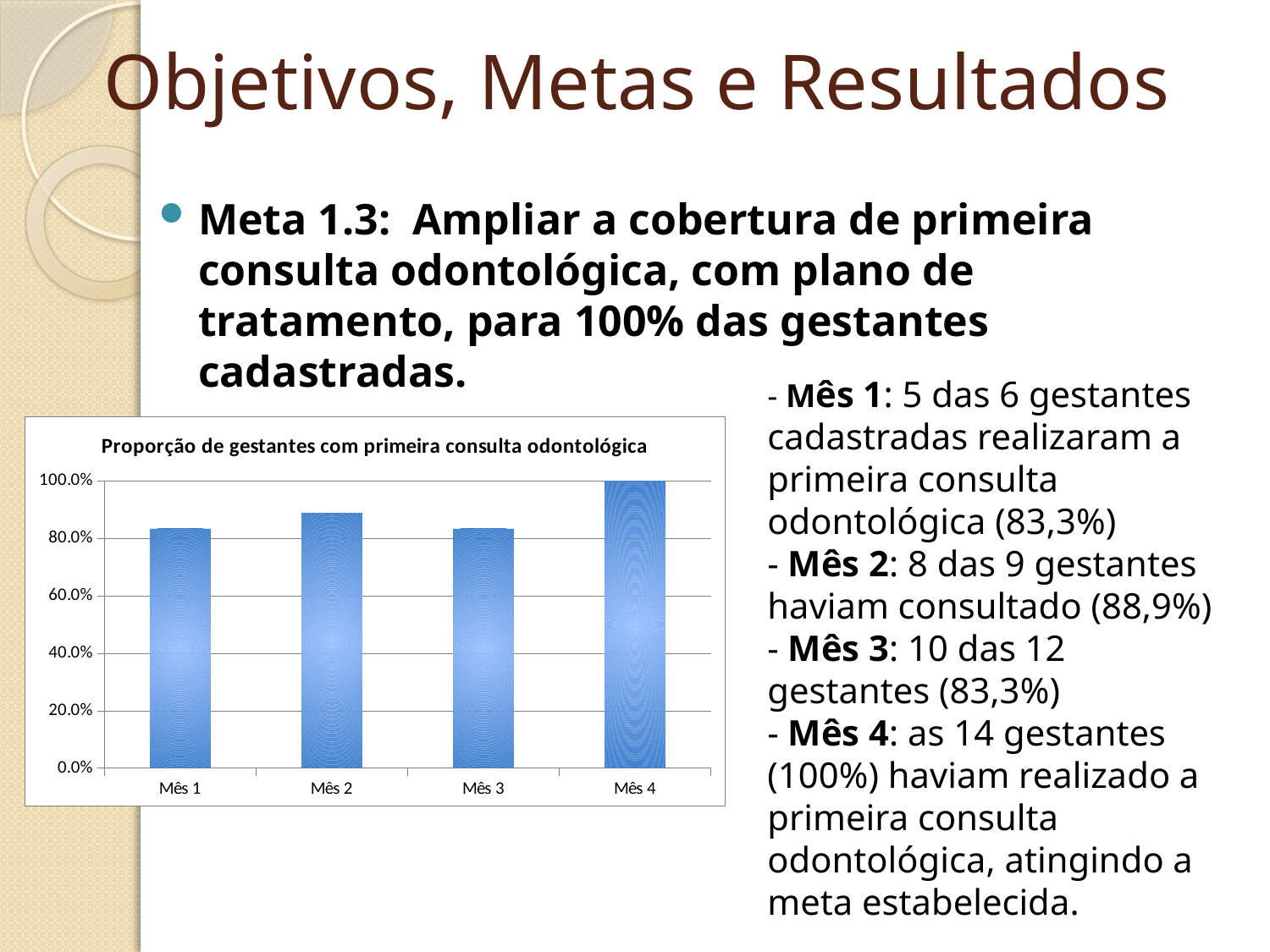
Is the value for Mês 1 greater or less than 80.0%? greater Which month has the highest bar in the chart? Mês 4 What is the value for Mês 4 in the chart? 100.0% Which is larger, the value for Mês 3 or the value for Mês 4? Mês 4 What is the title of the chart? Proporção de gestantes com primeira consulta odontológica Is the value for Mês 2 greater or less than 100.0%? less Which is larger, the value for Mês 1 or the value for Mês 2? Mês 2 What is the highest value shown on the y axis of the chart? 100.0% How many categories (months) are shown on the x axis of the chart? 4 Is the value for Mês 3 greater or less than 60.0%? greater What kind of chart is shown on the slide? bar chart